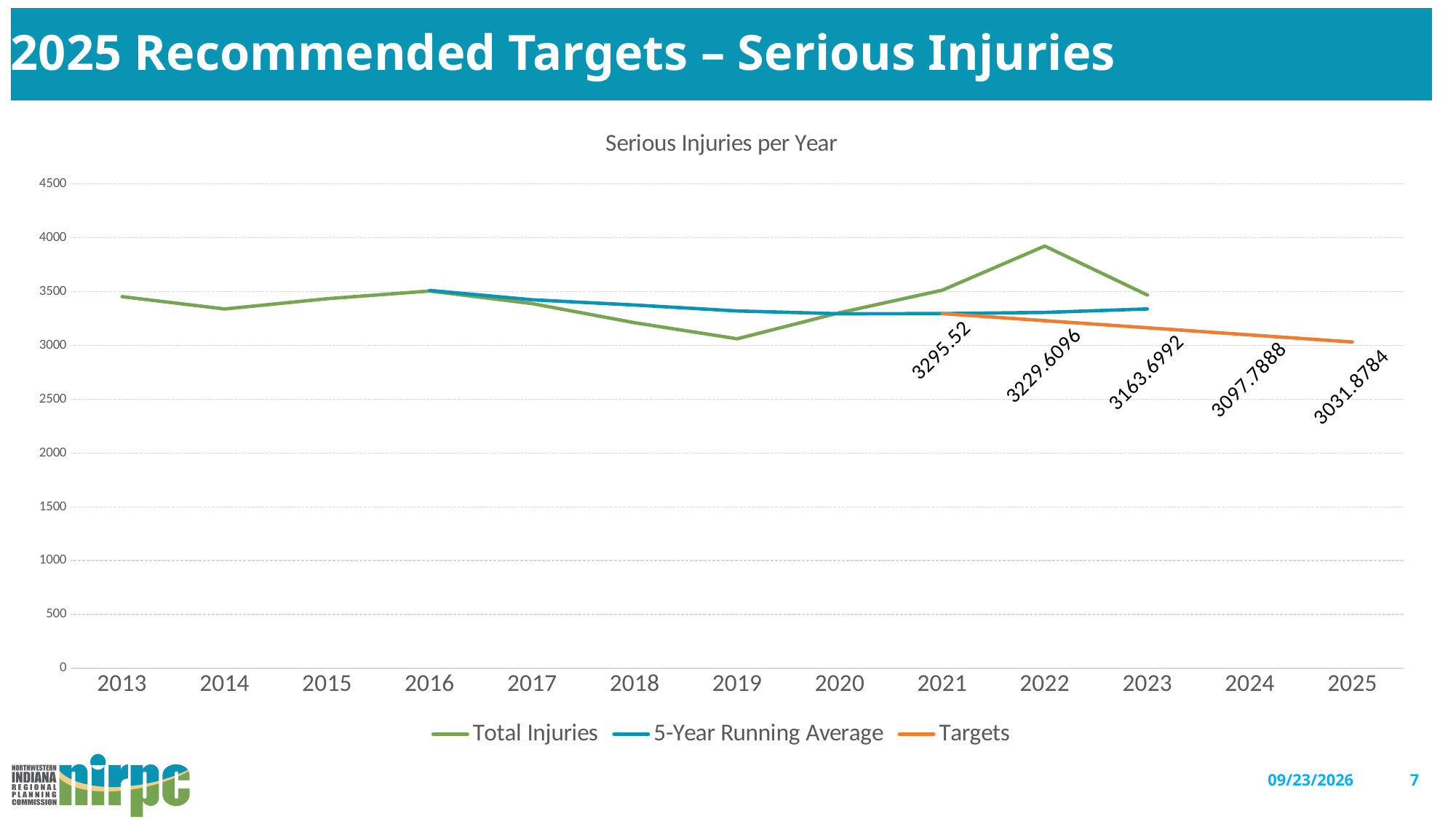
What is the Targets value for 2023? 3163.6992 Is the Total Injuries value for 2019 greater or less than 3500? less What is the Targets value for 2021? 3295.52 Is the Total Injuries value for 2022 greater or less than 3500? greater Do the Targets values rise or fall from 2021 to 2025? fall What kind of chart is shown on the slide? line chart How many years are shown on the x axis? 13 How many series does the legend list? 3 What is the Targets value for 2025? 3031.8784 In which year is the Total Injuries line at its highest? 2022 What is the difference between the Targets value for 2021 and the Targets value for 2025? 263.6416 In which year is the Total Injuries line at its lowest? 2019